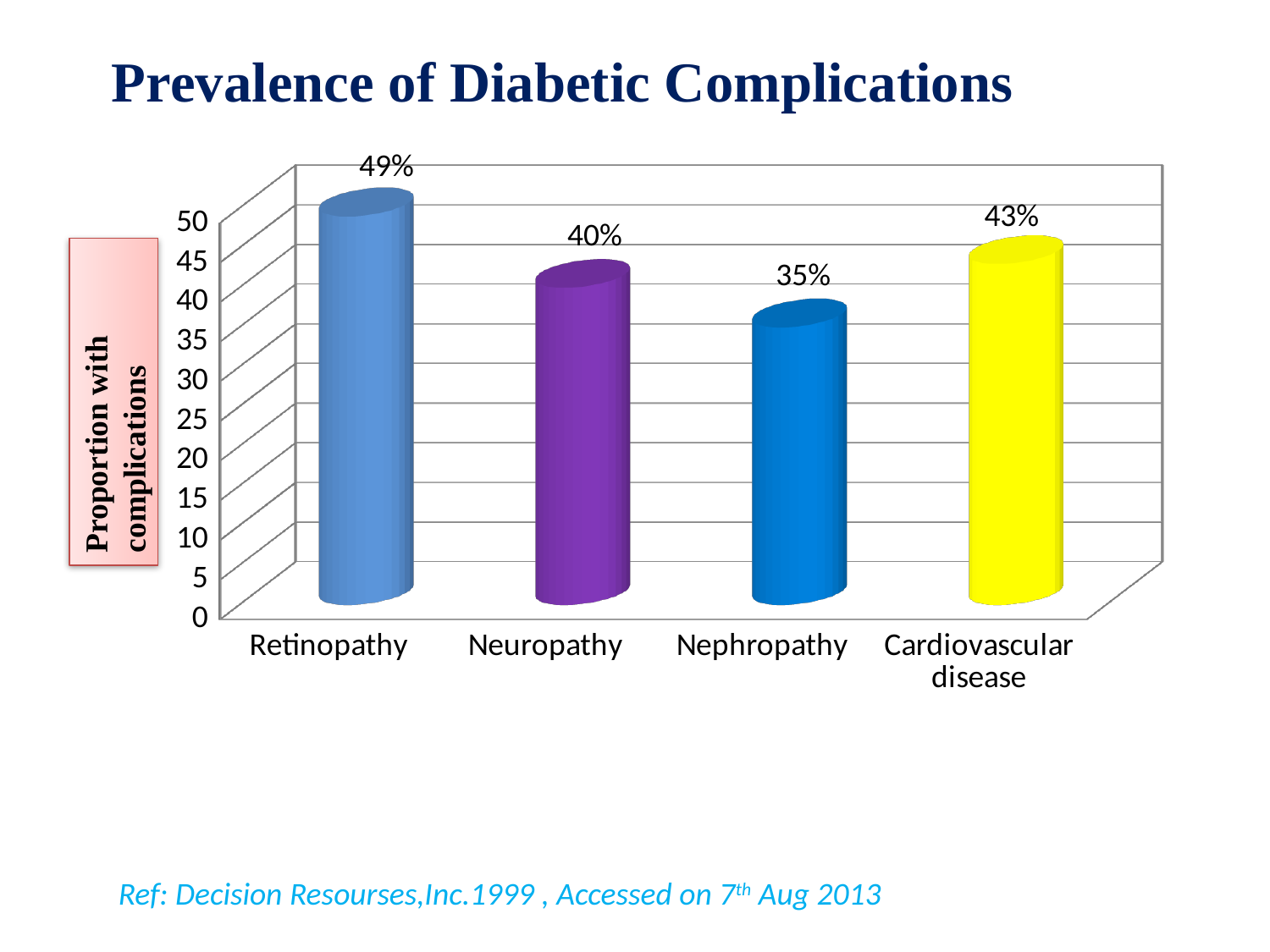
What is the value for Cardiovascular disease? 43% What is the value for Retinopathy? 49% What is the label on the vertical axis? Proportion with complications What is the value for Neuropathy? 40% What is the difference between the values for Retinopathy and Nephropathy? 14% Which complication has the highest prevalence? Retinopathy How many complication categories are shown in the chart? 4 What kind of chart is shown on the slide? Bar chart Which complication has the lowest prevalence? Nephropathy What is the title of the chart? Prevalence of Diabetic Complications What is the value for Nephropathy? 35% Which is larger, the value for Neuropathy or the value for Cardiovascular disease? Cardiovascular disease